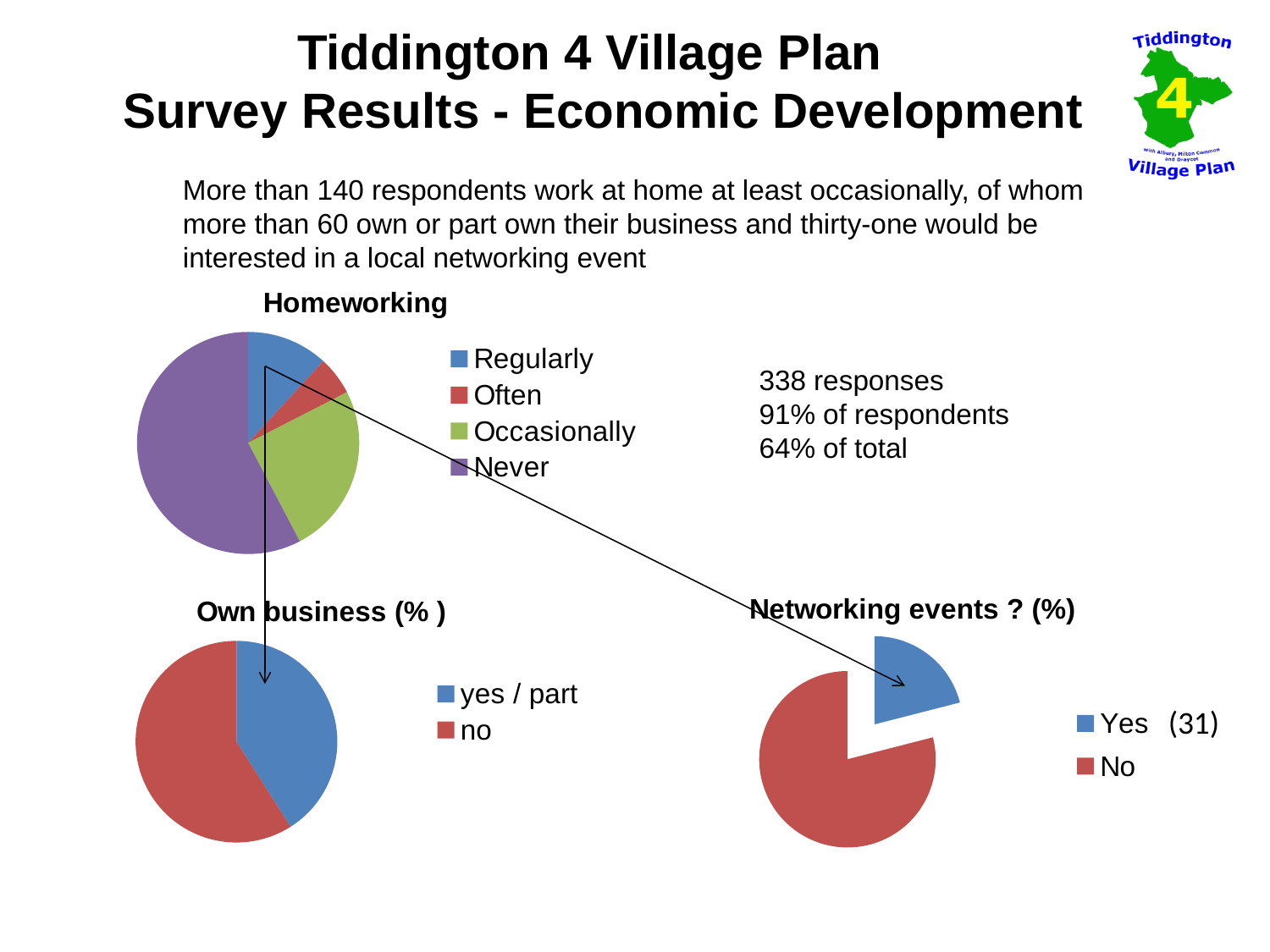
In the Homeworking pie chart, which category has the smallest slice? Often What colour is the Never slice in the Homeworking pie chart? purple What kind of chart is the Homeworking chart? pie chart In the Homeworking pie chart, which category has the largest slice? Never In the Own business (%) pie chart, which category has the larger slice? no In the Networking events ? (%) pie chart, which slice is larger, Yes or No? No In the Homeworking pie chart, which slice is larger, Occasionally or Never? Never In the Homeworking pie chart, which slice is larger, Regularly or Often? Regularly In the Networking events ? (%) chart, how many respondents answered Yes according to the legend? 31 How many categories does the Own business (%) pie chart show? 2 How many categories does the Homeworking pie chart show? 4 What is the title of the pie chart at the bottom left of the slide? Own business (% )